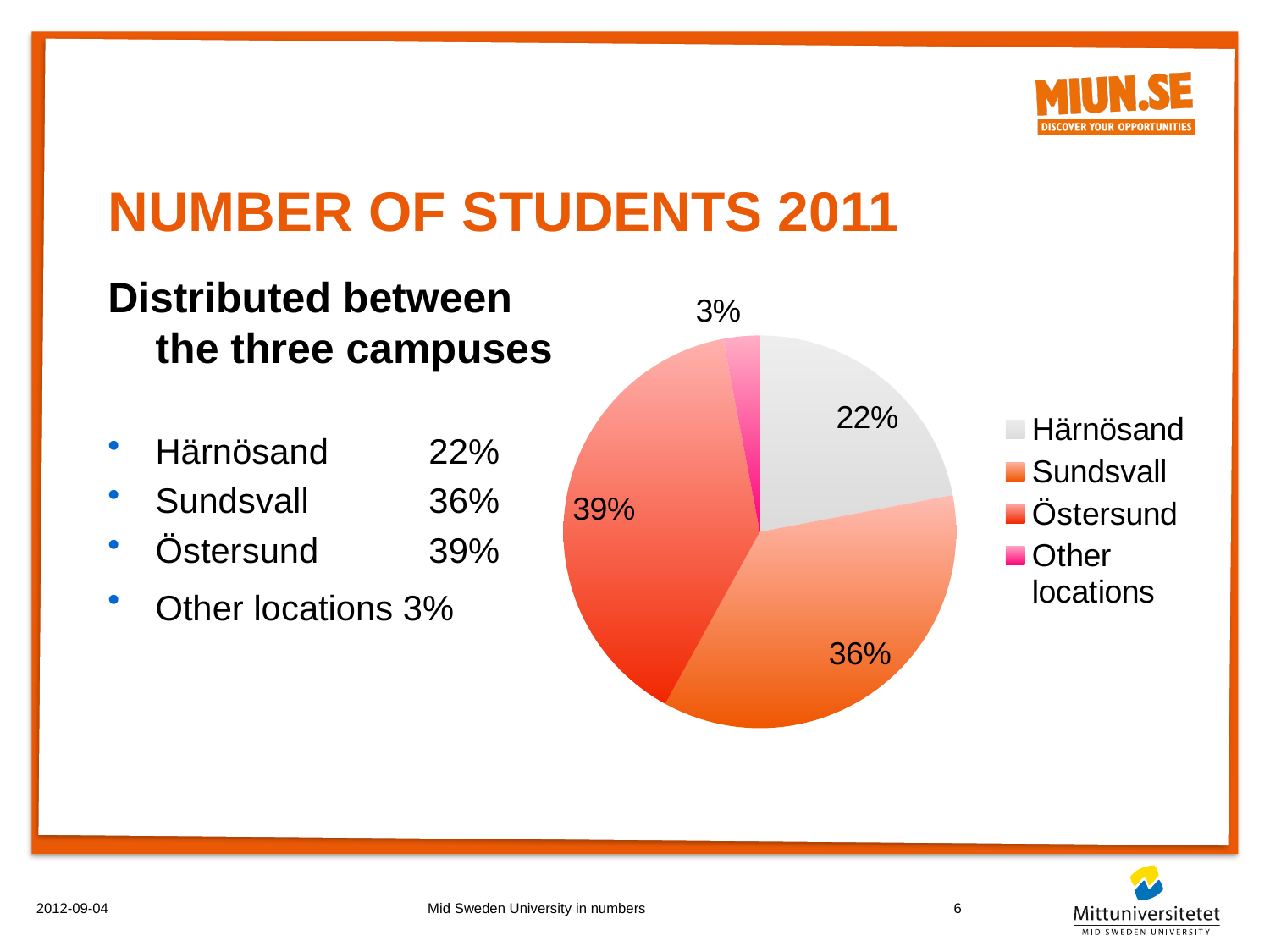
Which category is shown in grey in the legend? Härnösand What share of students does the Härnösand slice represent? 22% What kind of chart is shown on the slide? pie chart What share of students does the Sundsvall slice represent? 36% How many categories does the pie chart have? 4 What is the difference in percentage points between Sundsvall and Other locations? 33 Which category has the smallest slice of the pie? Other locations Which category has the largest slice of the pie? Östersund Which is larger, the share for Sundsvall or the share for Härnösand? Sundsvall What share of students does the Östersund slice represent? 39% What is the difference in percentage points between Östersund and Härnösand? 17